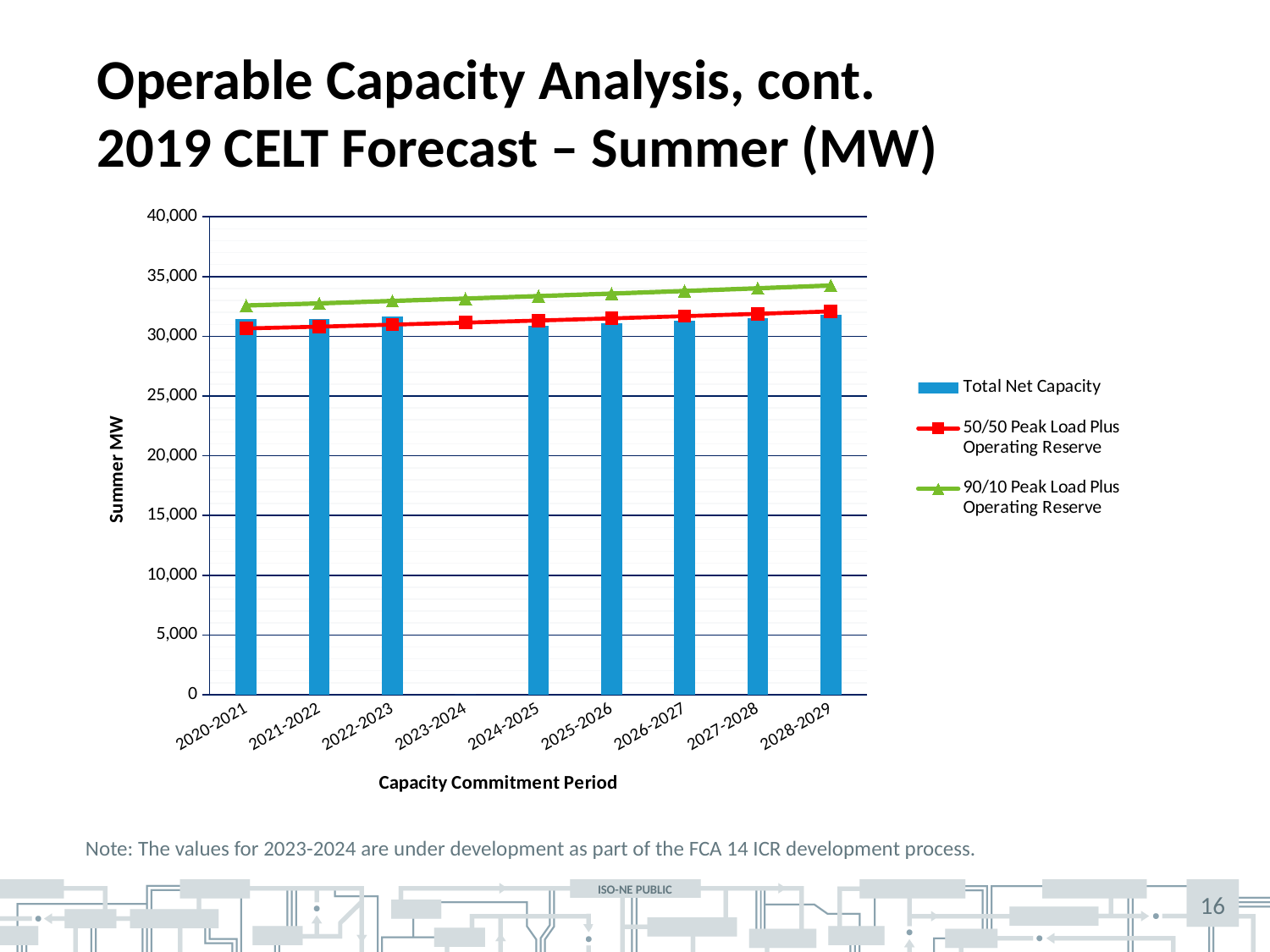
How many Total Net Capacity bars are plotted on the chart? 8 Which capacity commitment period has no Total Net Capacity bar plotted? 2023-2024 Is the 90/10 Peak Load Plus Operating Reserve value for 2020-2021 greater or less than 30,000? greater Is the Total Net Capacity value for 2020-2021 greater or less than 30,000? greater What is the title of the y axis? Summer MW What kind of chart is shown on the slide? A combined bar and line chart Which capacity commitment period has the highest 90/10 Peak Load Plus Operating Reserve value? 2028-2029 In 2028-2029, which is larger: the 90/10 Peak Load Plus Operating Reserve or the 50/50 Peak Load Plus Operating Reserve? 90/10 Peak Load Plus Operating Reserve How many series does the legend list? 3 Does the 90/10 Peak Load Plus Operating Reserve line rise or fall from 2020-2021 to 2028-2029? rise How many capacity commitment periods are shown on the x axis? 9 Is the 90/10 Peak Load Plus Operating Reserve value for 2028-2029 greater or less than 35,000? less